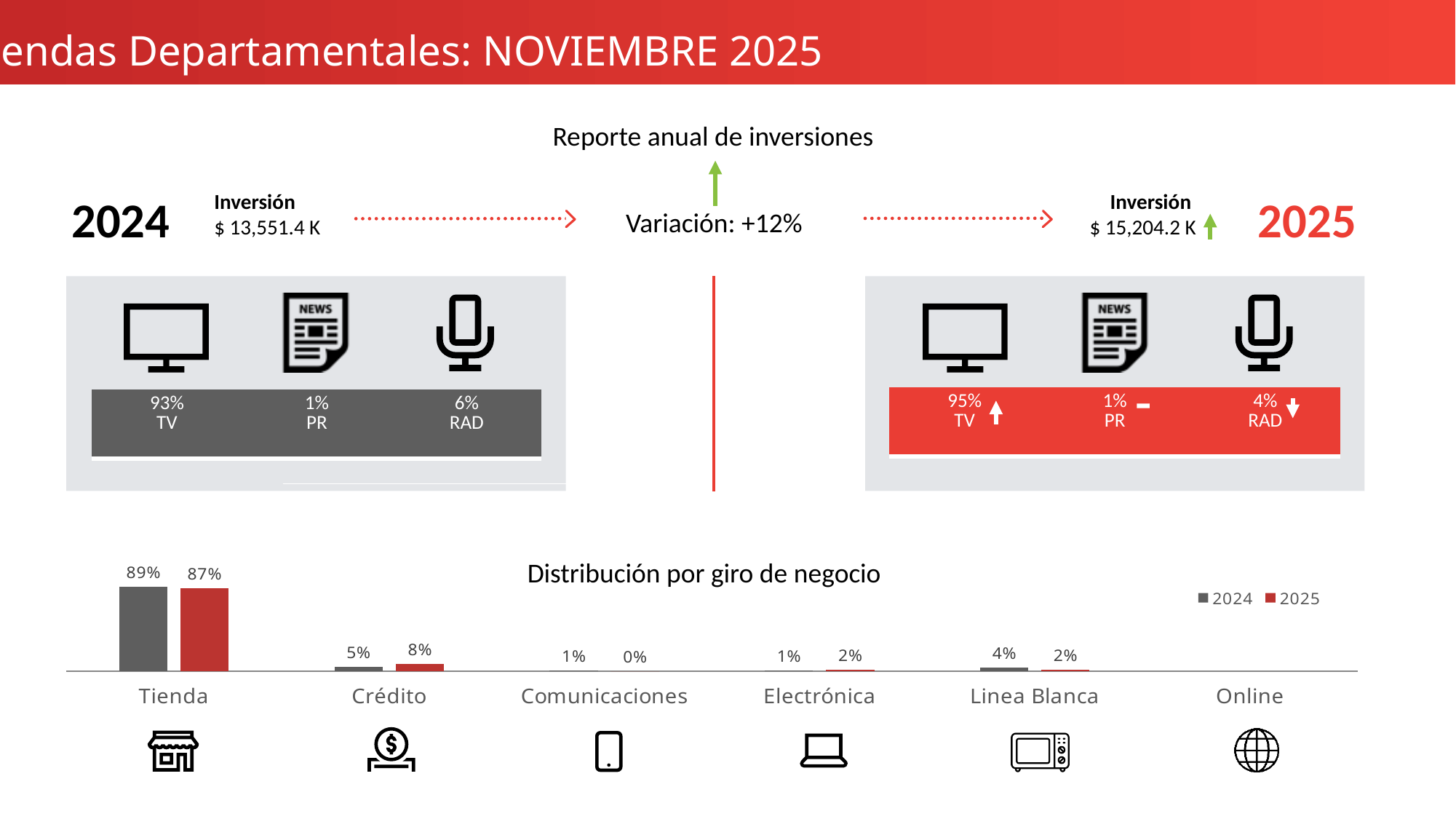
In the 'Distribución por giro de negocio' chart, which is larger for Electrónica: the 2024 value or the 2025 value? 2025 In the 'Distribución por giro de negocio' chart, what is the difference between the 2024 and 2025 values for Tienda? 2% In the 'Distribución por giro de negocio' chart, which is larger for Linea Blanca: the 2024 value or the 2025 value? 2024 How many categories are shown on the x axis of the 'Distribución por giro de negocio' chart? 6 In the 'Distribución por giro de negocio' chart, what is the 2025 value for Crédito? 8% In the 'Distribución por giro de negocio' chart, what is the 2024 value for Linea Blanca? 4% What kind of chart is 'Distribución por giro de negocio'? Bar chart How many series does the legend of the 'Distribución por giro de negocio' chart list? 2 In the 'Distribución por giro de negocio' chart, what is the difference between the 2025 and 2024 values for Crédito? 3% In the 'Distribución por giro de negocio' chart, what is the 2025 value for Comunicaciones? 0% In the 'Distribución por giro de negocio' chart, what is the 2024 value for Tienda? 89% In the 'Distribución por giro de negocio' chart, which category has the highest 2025 value? Tienda